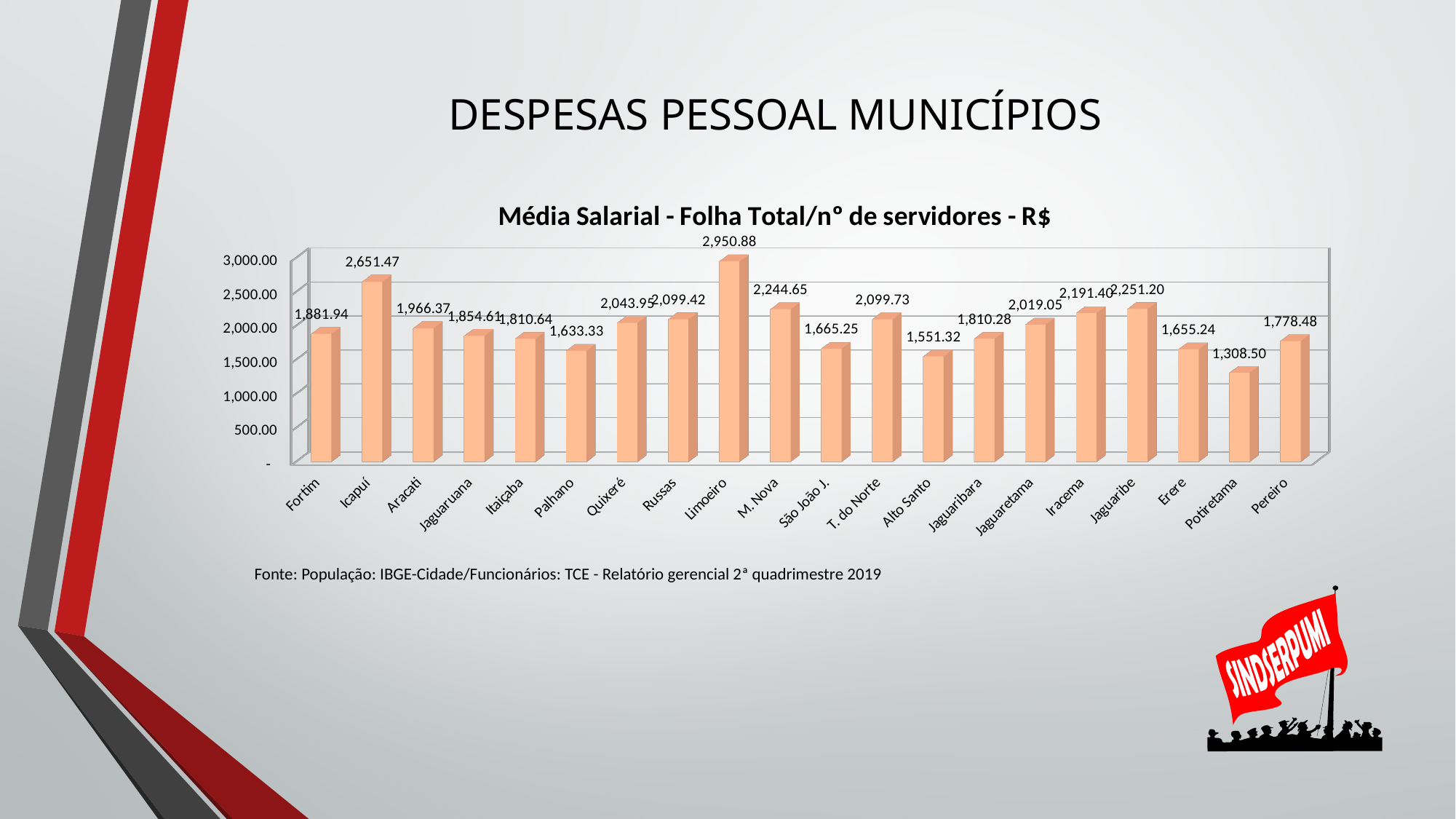
Which has a larger value, Icapuí or M. Nova? Icapuí What is the difference between the values for Icapuí and Fortim? 769.53 What is the value for Potiretama in the chart? 1,308.50 What is the value for Limoeiro in the chart? 2,950.88 Which municipality has the highest value in the chart? Limoeiro What is the value for Icapuí in the chart? 2,651.47 How many municipalities are shown in the chart? 20 What is the title of the chart? Média Salarial - Folha Total/nº de servidores - R$ What is the difference between the values for Limoeiro and Potiretama? 1,642.38 Which municipality has the lowest value in the chart? Potiretama Is the value for Alto Santo greater or less than 2,000.00? less What kind of chart is shown on the slide? bar chart